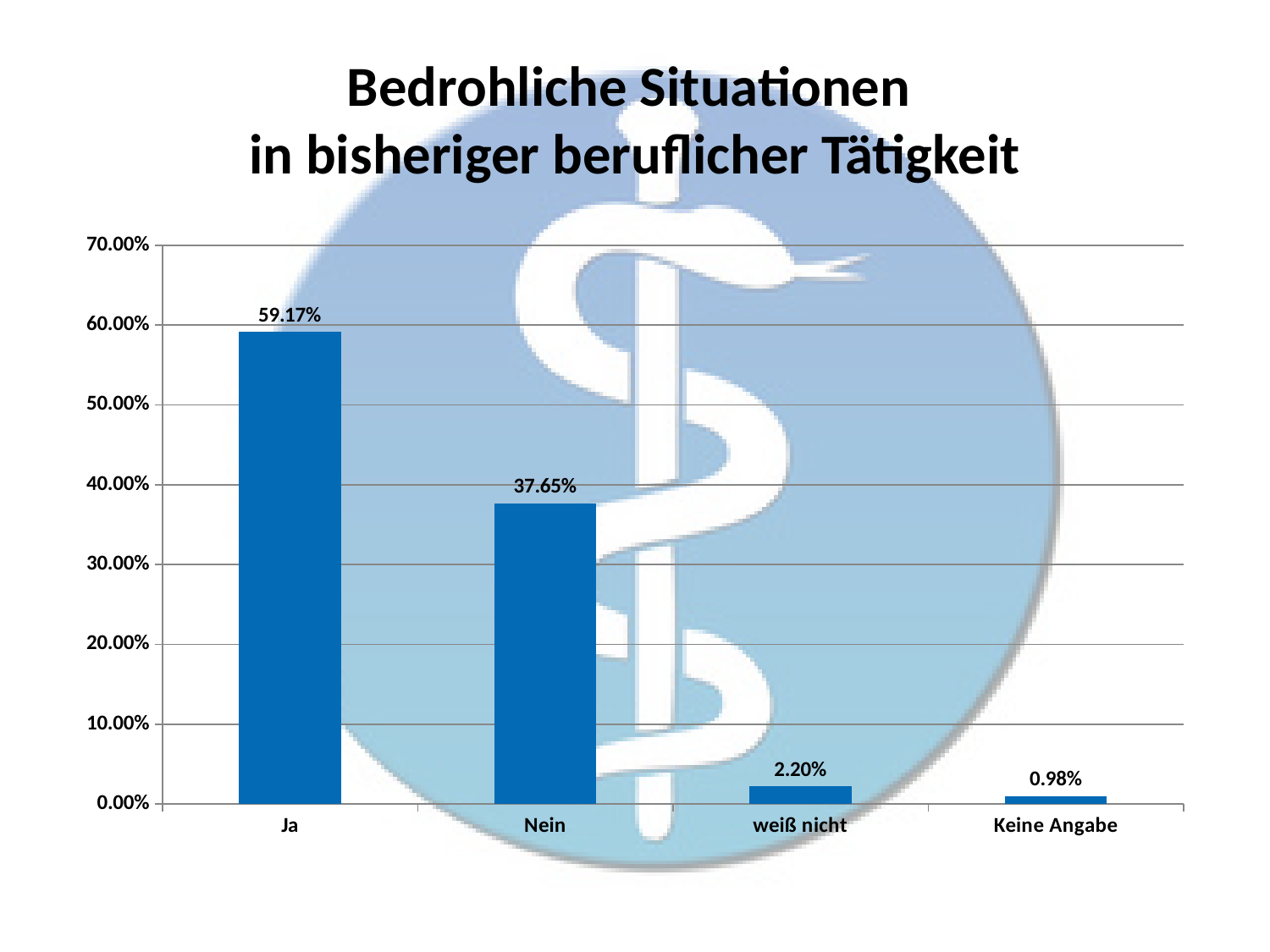
What is the value for "Keine Angabe"? 0.98% Which category has the highest value? Ja What kind of chart is shown on the slide? bar chart What is the difference between the values for "Ja" and "Nein"? 21.52% How many categories are shown on the x axis? 4 Which is larger, the value for "weiß nicht" or the value for "Keine Angabe"? weiß nicht What is the value for "weiß nicht"? 2.20% What is the value for "Ja"? 59.17% Is the value for "Nein" greater or less than 40.00%? less What is the value for "Nein"? 37.65% What is the title of the chart? Bedrohliche Situationen in bisheriger beruflicher Tätigkeit Which category has the lowest value? Keine Angabe